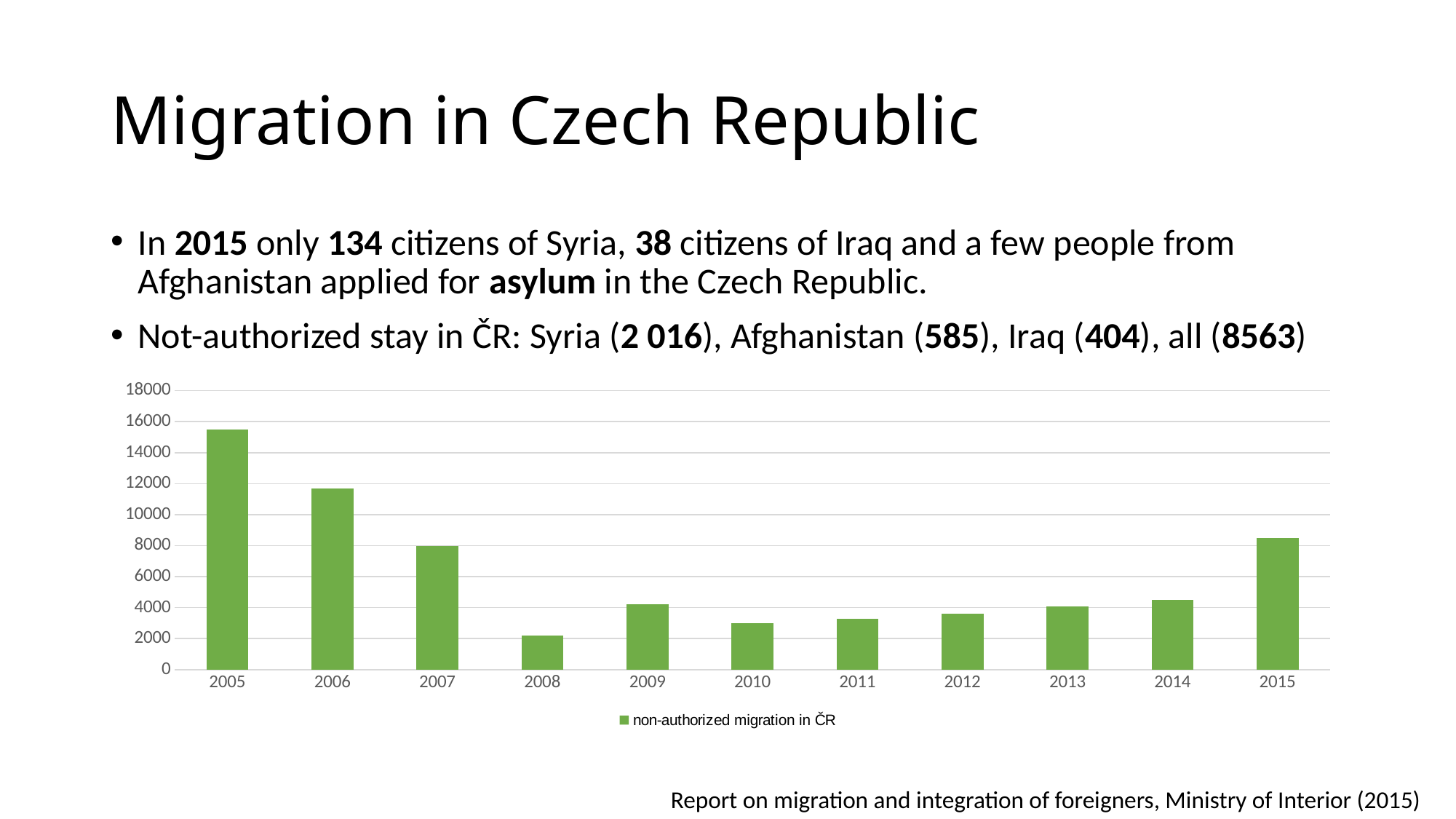
What kind of chart is shown on the slide? bar chart Which year has the larger value, 2006 or 2007? 2006 Is the value for 2005 greater or less than 14000? greater Which year has the highest value for non-authorized migration in ČR? 2005 Is the value for 2006 greater or less than 10000? greater What is the series name shown in the chart legend? non-authorized migration in ČR Is the value for 2010 greater or less than 4000? less How many years are shown on the x axis of the chart? 11 How many series does the chart legend list? 1 Which year has the lowest value for non-authorized migration in ČR? 2008 Do the values rise or fall from 2005 to 2008? fall